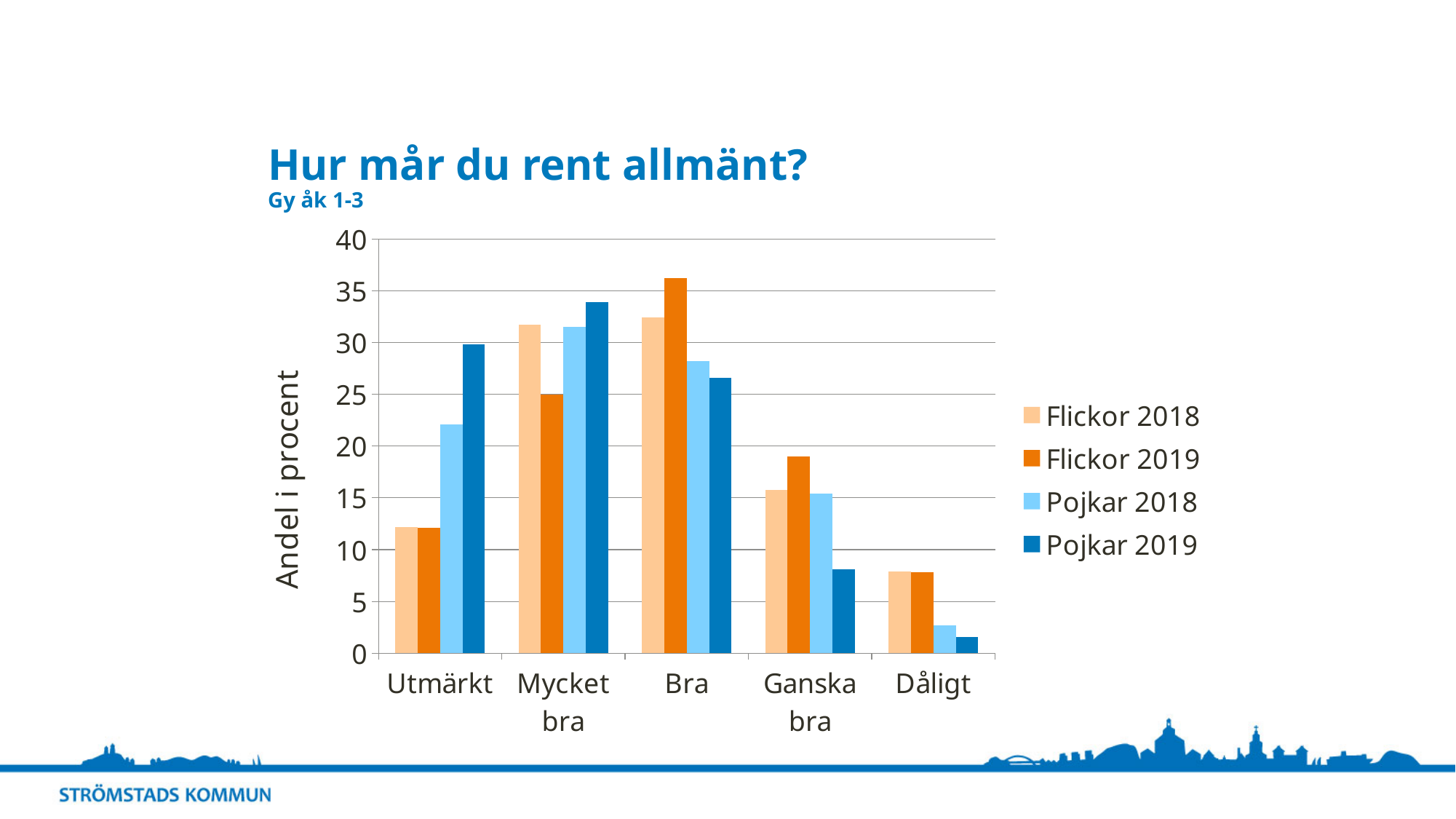
For which category is the Flickor 2019 bar highest? Bra Is the value for Flickor 2019 at Mycket bra greater or less than 30? less What kind of chart is shown on the slide? bar chart For which category is the Pojkar 2019 bar highest? Mycket bra For which category is the Pojkar 2019 bar lowest? Dåligt At Utmärkt, which is larger: Pojkar 2018 or Pojkar 2019? Pojkar 2019 Is the value for Pojkar 2018 at Dåligt greater or less than 5? less Is the value for Pojkar 2019 at Utmärkt greater or less than 25? greater How many series does the legend list? 4 At Ganska bra, which is larger: Flickor 2019 or Pojkar 2019? Flickor 2019 What is the label on the vertical axis? Andel i procent How many categories are shown on the x axis? 5